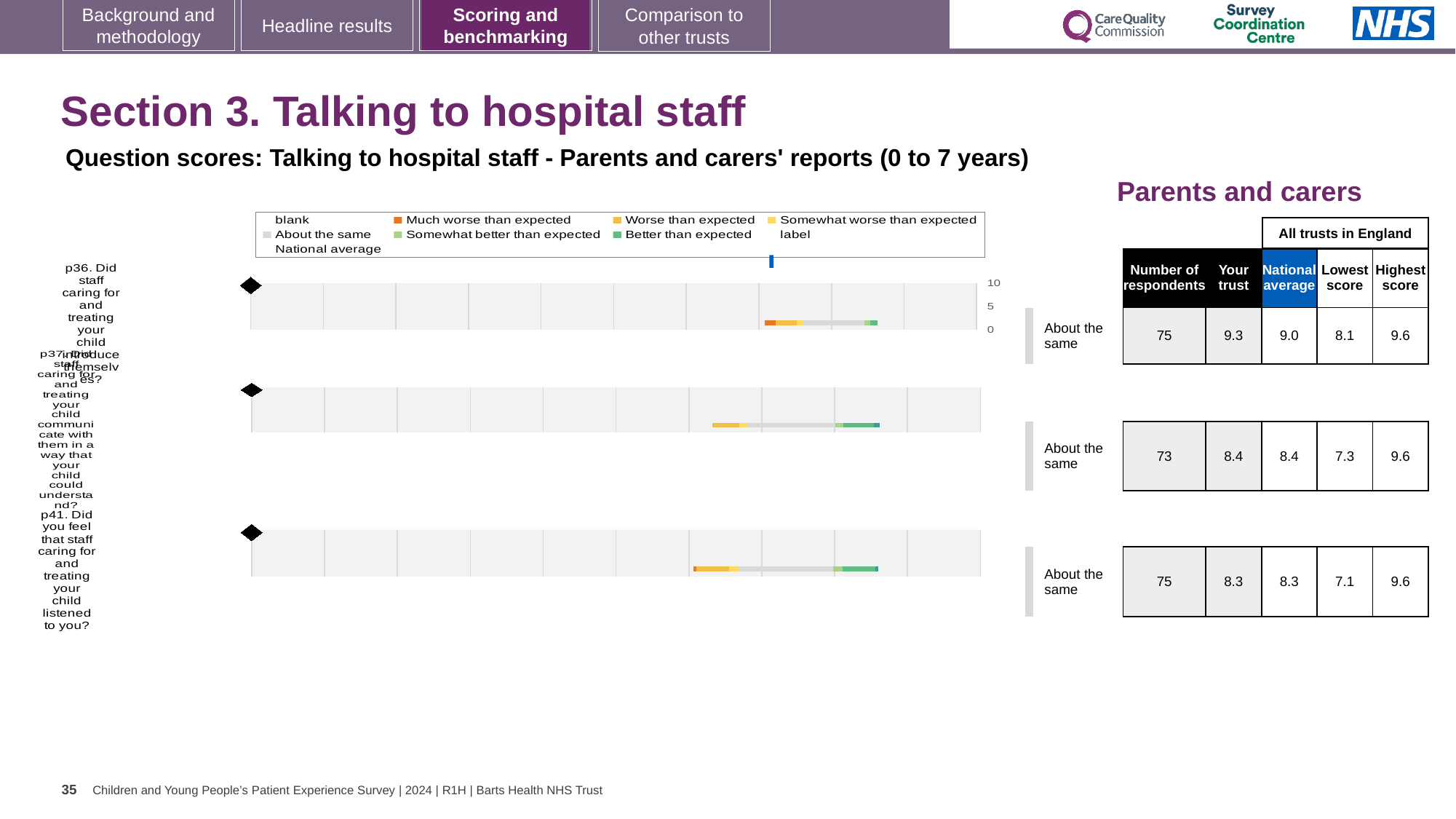
What benchmark category is shown for p36? About the same What is the 'Your trust' score for p36 (Did staff caring for and treating your child introduce themselves?)? 9.3 What is the lowest score across all trusts in England for p41? 7.1 Which question has the lowest 'Your trust' score? p41 How many questions are plotted on the slide? 3 What is the highest score across all trusts in England for p36? 9.6 What kind of chart is used to show each question score? Bar chart Which question has the highest 'Your trust' score? p36 How many respondents answered p41 (Did you feel that staff caring for and treating your child listened to you?)? 75 What is the difference between the 'Your trust' score and the national average for p36? 0.3 What is the national average score for p37 (Did staff communicate with them in a way that your child could understand?)? 8.4 Which has the higher lowest score across all trusts in England: p37 or p41? p37